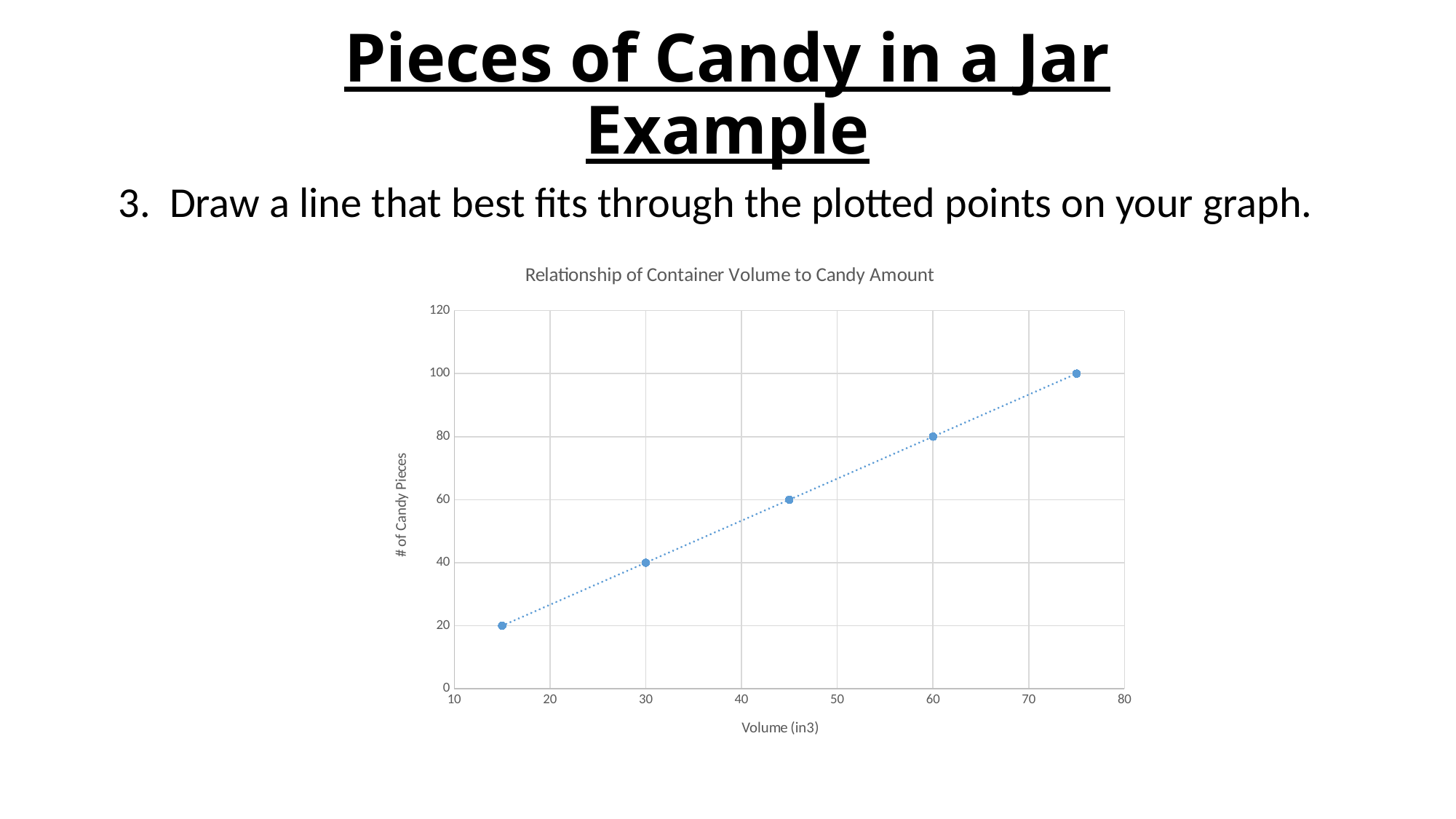
What is the lowest number of candy pieces plotted on the chart? 20 How many data points are plotted on the chart? 5 Which has more candy pieces: a volume of 30 or a volume of 60? 60 What is the number of candy pieces at a volume of 30? 40 Do the number of candy pieces rise or fall as volume increases? rise What is the number of candy pieces at a volume of 60? 80 What is the difference in candy pieces between a volume of 60 and a volume of 30? 40 What is the highest number of candy pieces plotted on the chart? 100 What is the label of the x axis? Volume (in3) What kind of chart is shown on the slide? Scatter plot What is the title of the chart? Relationship of Container Volume to Candy Amount Is the number of candy pieces at a volume of 30 greater or less than 60? less